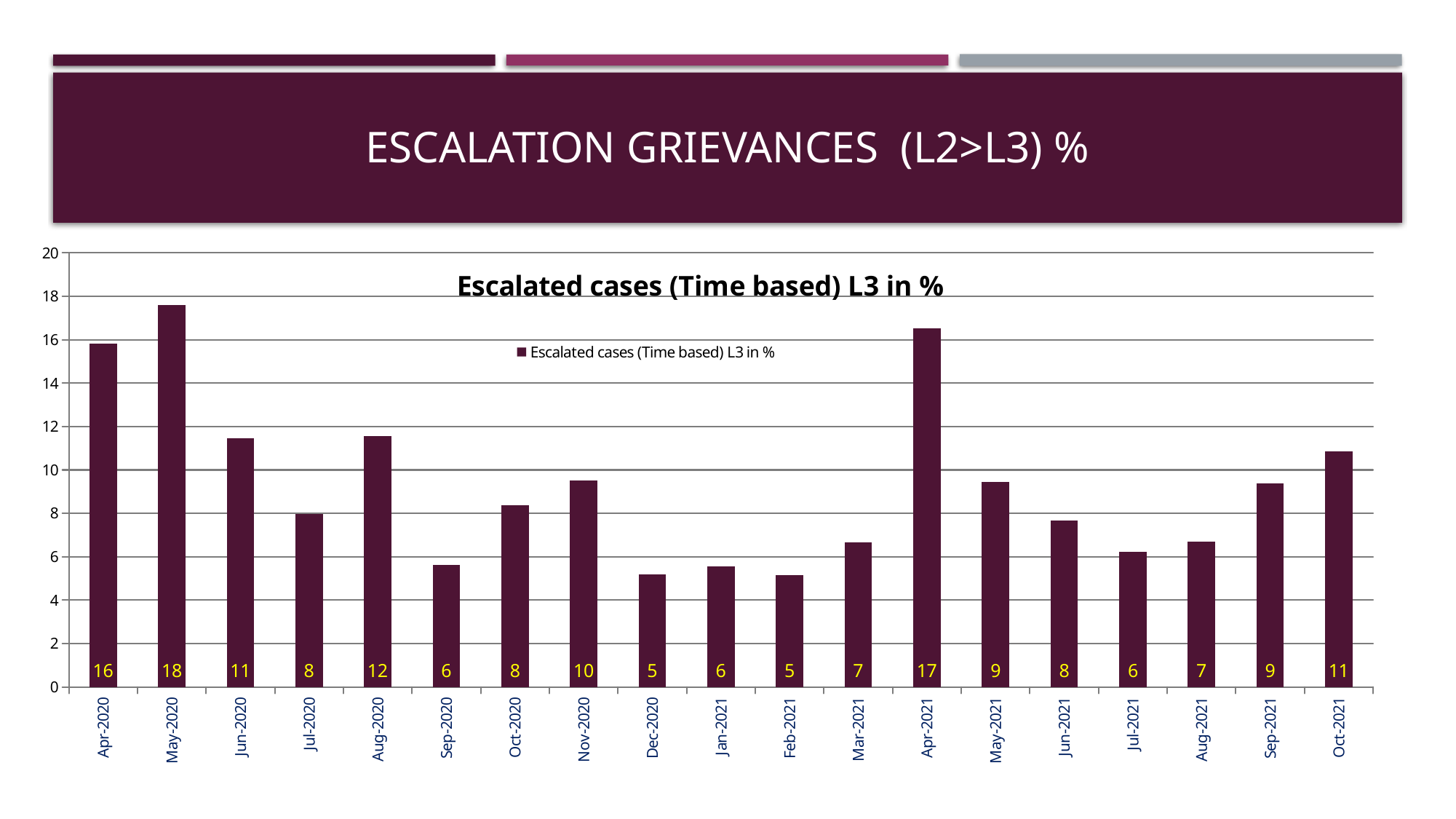
What is the difference between the values for May-2020 and Apr-2021? 1 What is the value for Apr-2021? 17 Is the value for Dec-2020 greater or less than 6? less How many months are shown on the x axis? 19 Which is larger, the value for Aug-2020 or the value for Nov-2020? Aug-2020 What is the value for Oct-2021? 11 What is the value for May-2020? 18 Which month has the highest value? May-2020 What is the difference between the values for Jun-2020 and Sep-2020? 5 What kind of chart is shown? bar chart Do the values rise or fall from Apr-2021 to Jul-2021? fall How many series does the legend list? 1